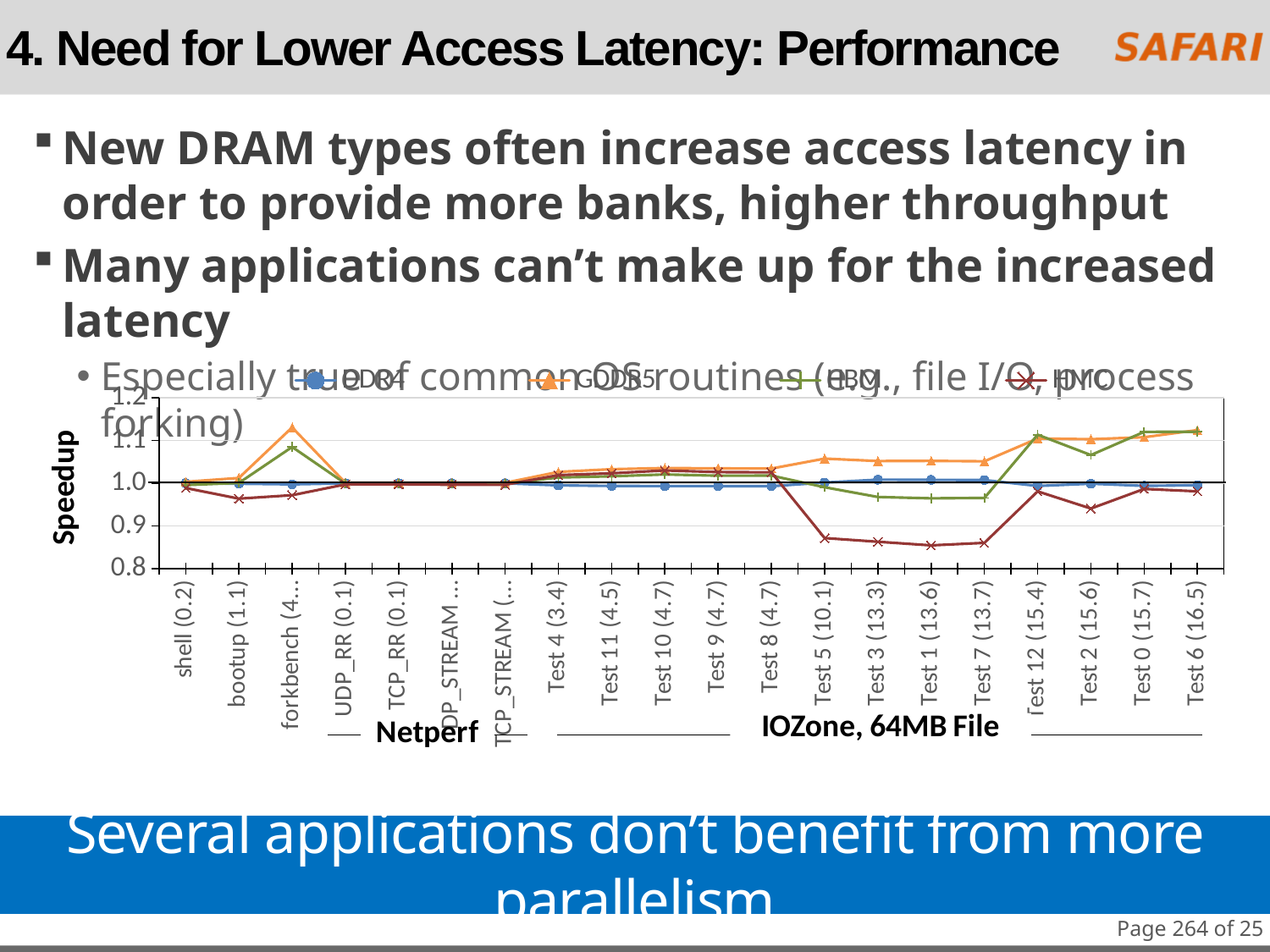
What kind of chart is shown on the slide? line chart Which two benchmark groups are labelled beneath the x axis of the chart? Netperf and IOZone, 64MB File Is the GDDR5 value for forkbench greater or less than 1.1? greater Which series has the highest speedup for forkbench? GDDR5 How many categories are plotted along the x axis of the chart? 20 What is the title of the y axis of the chart? Speedup Which series has the lowest speedup for Test 1 (13.6)? HMC How many series does the chart's legend list? 4 Is the HBM value for Test 6 (16.5) greater or less than 1.1? greater